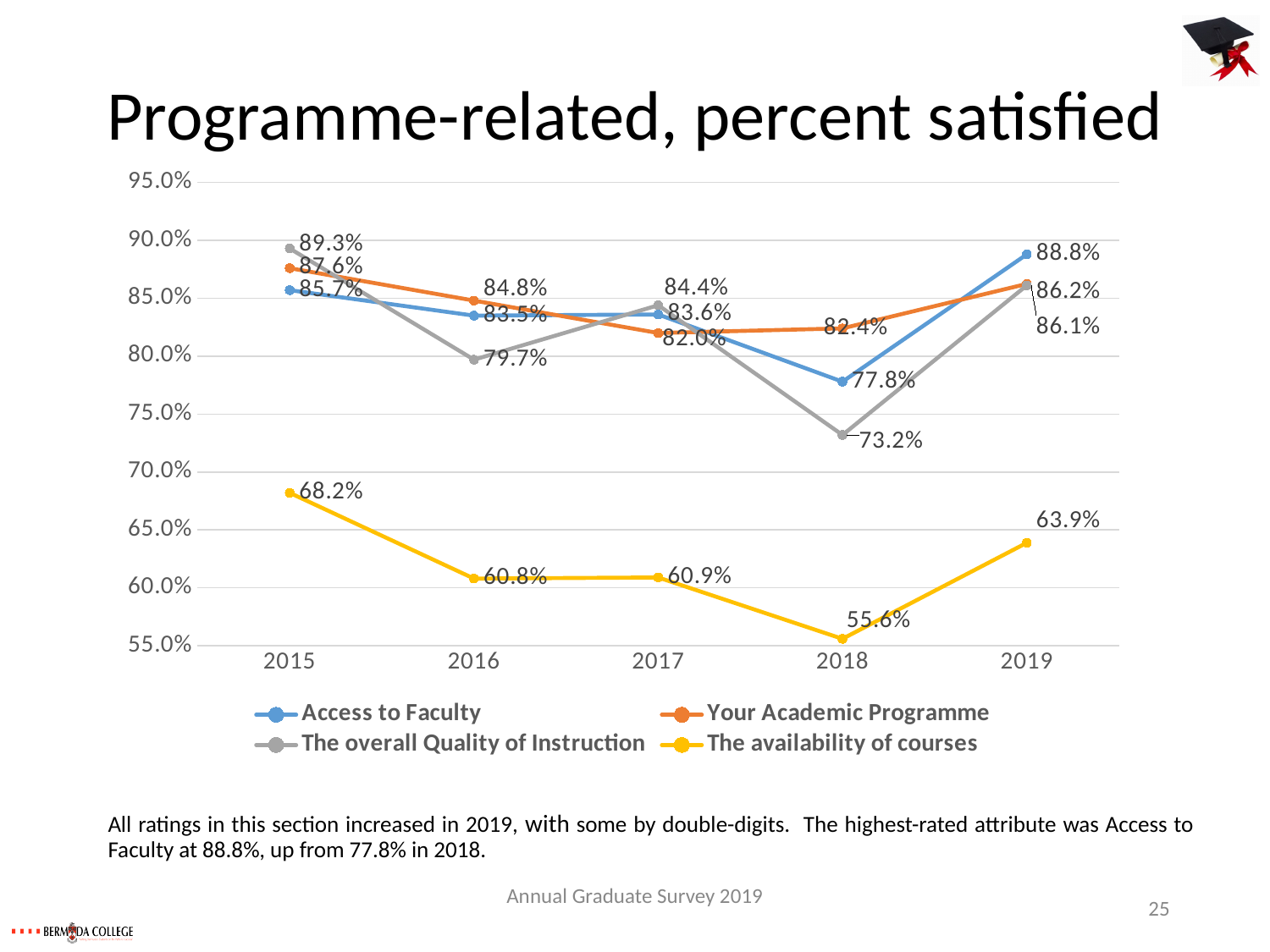
What was the percent satisfied for The overall Quality of Instruction in 2015? 89.3% How many years are plotted along the x axis? 5 What was the percent satisfied for The availability of courses in 2018? 55.6% In 2018, which was rated higher: Your Academic Programme or Access to Faculty? Your Academic Programme In which year was Access to Faculty rated lowest? 2018 In which year was The availability of courses rated highest? 2015 How many series does the legend list? 4 By how many percentage points did Access to Faculty increase from 2018 to 2019? 11.0 percentage points What kind of chart is shown on the slide? Line chart What was the percent satisfied for Access to Faculty in 2019? 88.8% What was the percent satisfied for Your Academic Programme in 2016? 84.8% Did The availability of courses rise or fall from 2017 to 2018? Fall